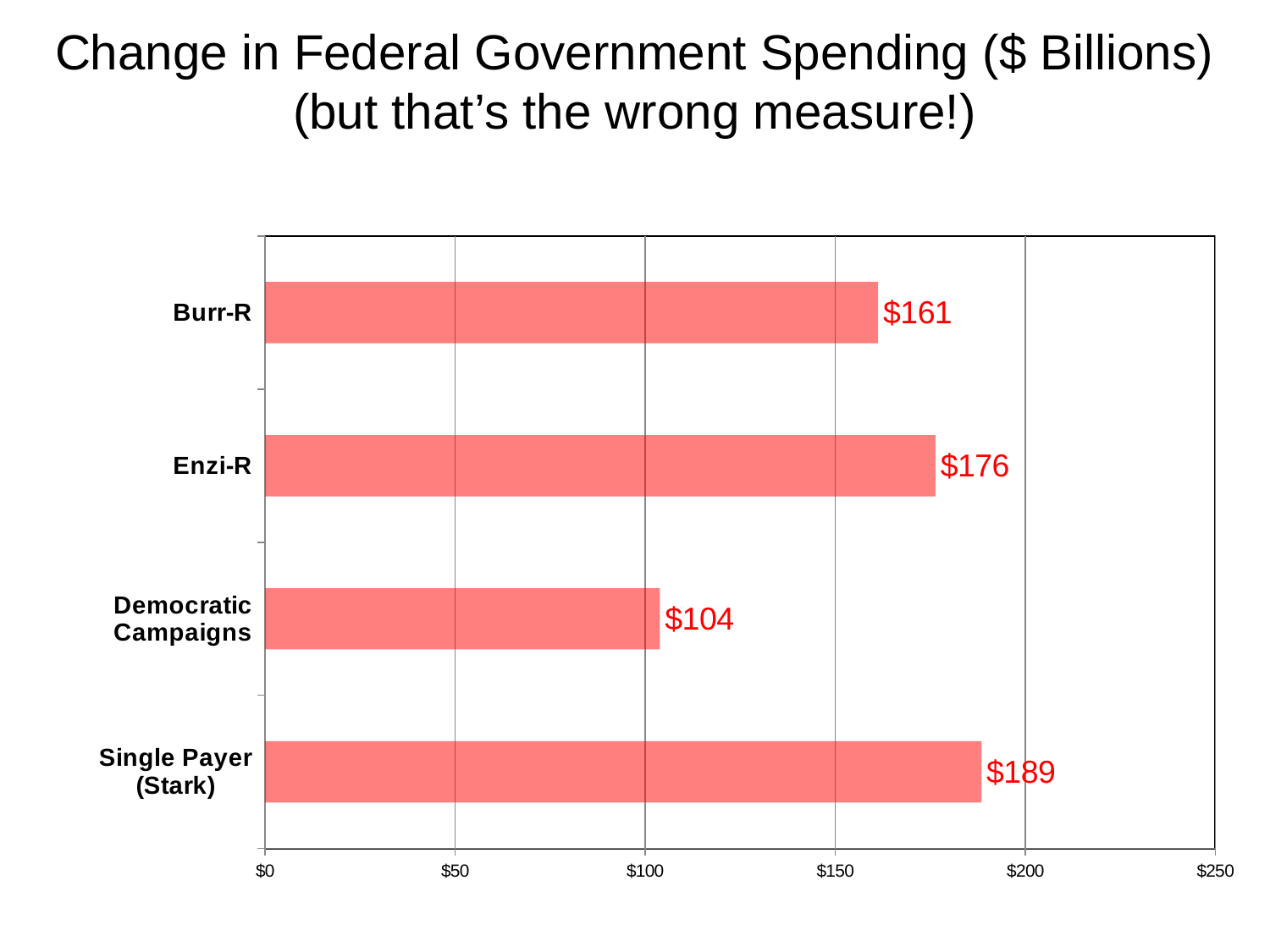
Which is larger, the value for Burr-R or the value for Enzi-R? Enzi-R What is the difference between the values for Single Payer (Stark) and Democratic Campaigns? $85 How many categories are shown in the chart? 4 Which category has the highest value? Single Payer (Stark) What is the value for Democratic Campaigns? $104 What is the value for Burr-R? $161 What is the value for Enzi-R? $176 Which category has the lowest value? Democratic Campaigns What is the value for Single Payer (Stark)? $189 Is the value for Democratic Campaigns greater or less than $150? less What kind of chart is shown on the slide? bar chart What is the difference between the values for Enzi-R and Burr-R? $15